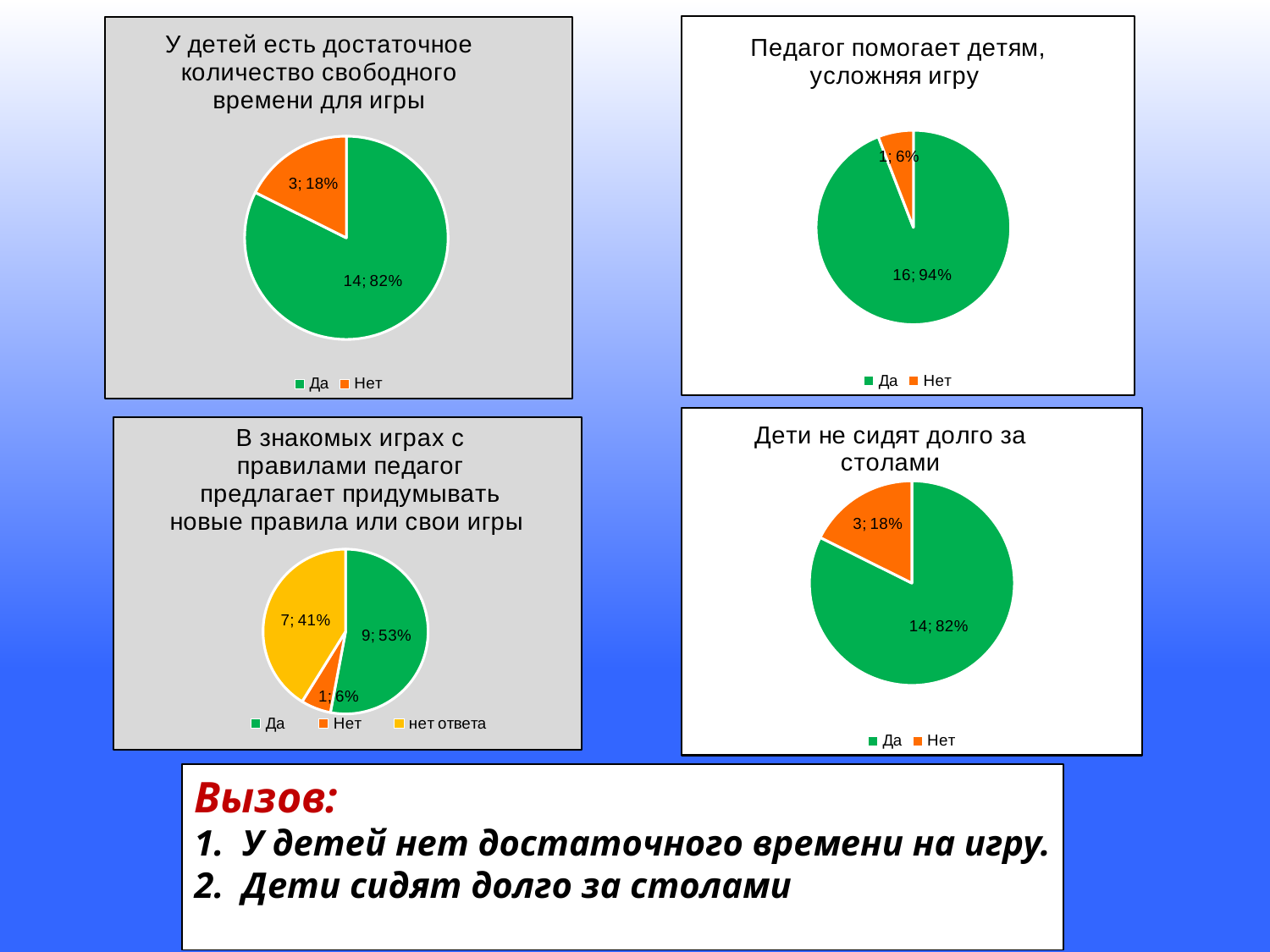
In the top-left chart 'У детей есть достаточное количество свободного времени для игры', what is the count for 'Нет'? 3 How many categories does the legend of the bottom-left chart 'В знакомых играх с правилами педагог предлагает придумывать новые правила или свои игры' list? 3 In the bottom-left chart 'В знакомых играх с правилами педагог предлагает придумывать новые правила или свои игры', which category is the smallest? Нет In the bottom-left chart 'В знакомых играх с правилами педагог предлагает придумывать новые правила или свои игры', what share of the pie is 'нет ответа'? 41% In the bottom-left chart 'В знакомых играх с правилами педагог предлагает придумывать новые правила или свои игры', which category is the largest? Да In the bottom-right chart 'Дети не сидят долго за столами', what is the count for 'Да'? 14 In the bottom-left chart 'В знакомых играх с правилами педагог предлагает придумывать новые правила или свои игры', what colour represents 'нет ответа'? Yellow In the top-left chart 'У детей есть достаточное количество свободного времени для игры', what share of the pie is 'Да'? 82% In the top-right chart 'Педагог помогает детям, усложняя игру', what is the count for 'Да'? 16 In the top-right chart 'Педагог помогает детям, усложняя игру', what share of the pie is 'Нет'? 6% What type of chart is the top-right chart 'Педагог помогает детям, усложняя игру'? Pie chart In the bottom-right chart 'Дети не сидят долго за столами', what is the difference between the counts for 'Да' and 'Нет'? 11